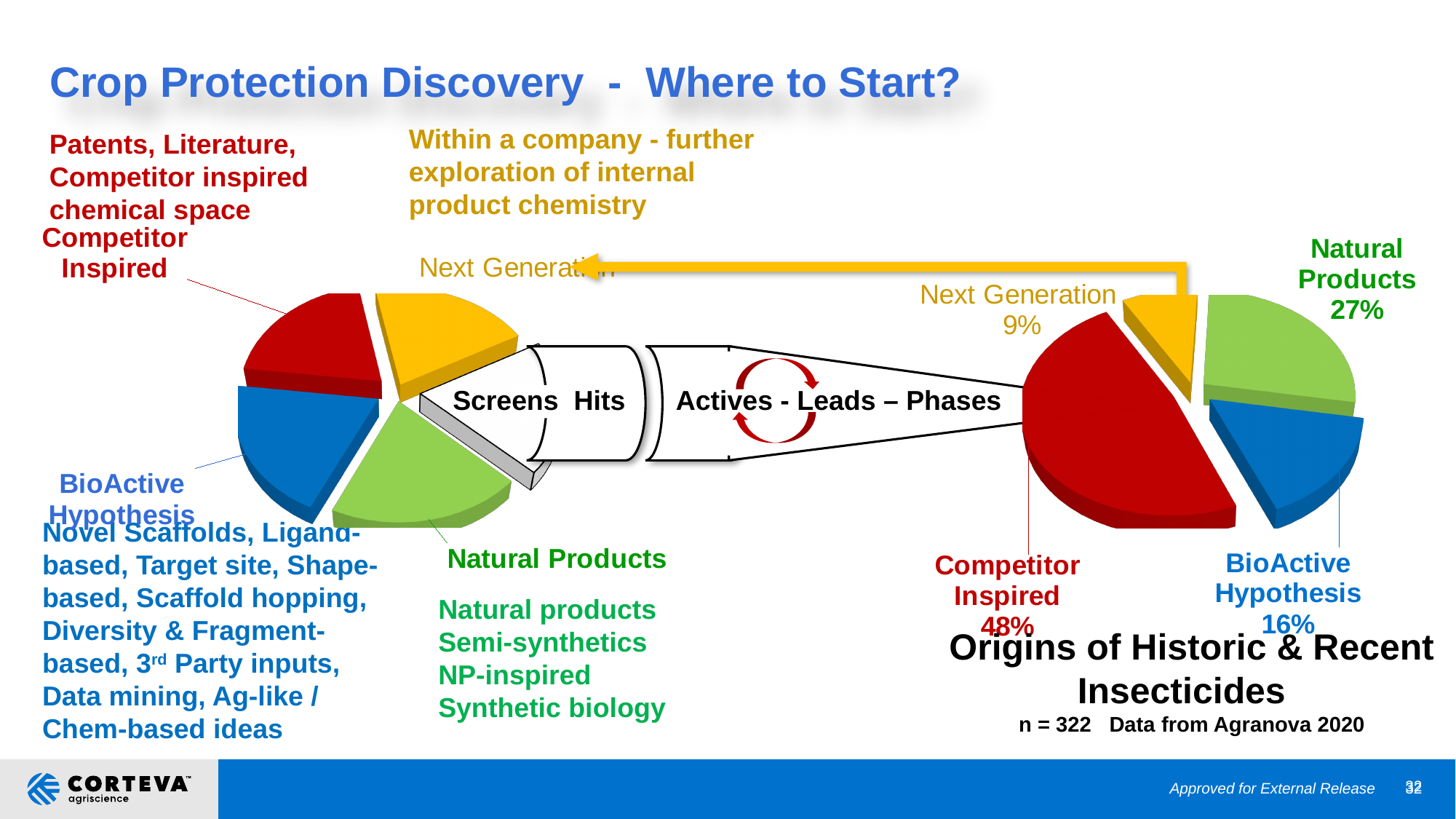
In the 'Origins of Historic & Recent Insecticides' pie chart, what is the difference in percentage points between Competitor Inspired and Natural Products? 21 In the 'Origins of Historic & Recent Insecticides' pie chart, what percentage is labelled for BioActive Hypothesis? 16% In the 'Origins of Historic & Recent Insecticides' pie chart, which is larger: Natural Products or BioActive Hypothesis? Natural Products In the 'Origins of Historic & Recent Insecticides' pie chart, which category has the largest share? Competitor Inspired In the 'Origins of Historic & Recent Insecticides' pie chart, what percentage is labelled for Competitor Inspired? 48% In the 'Origins of Historic & Recent Insecticides' pie chart, what percentage is labelled for Natural Products? 27% In the 'Origins of Historic & Recent Insecticides' pie chart, which category has the smallest share? Next Generation What kind of chart is the chart on the right of the slide, titled 'Origins of Historic & Recent Insecticides'? Pie chart In the 'Origins of Historic & Recent Insecticides' pie chart, what percentage is labelled for Next Generation? 9% How many slices does the 'Origins of Historic & Recent Insecticides' pie chart have? 4 What sample size (n) is stated below the 'Origins of Historic & Recent Insecticides' pie chart? n = 322